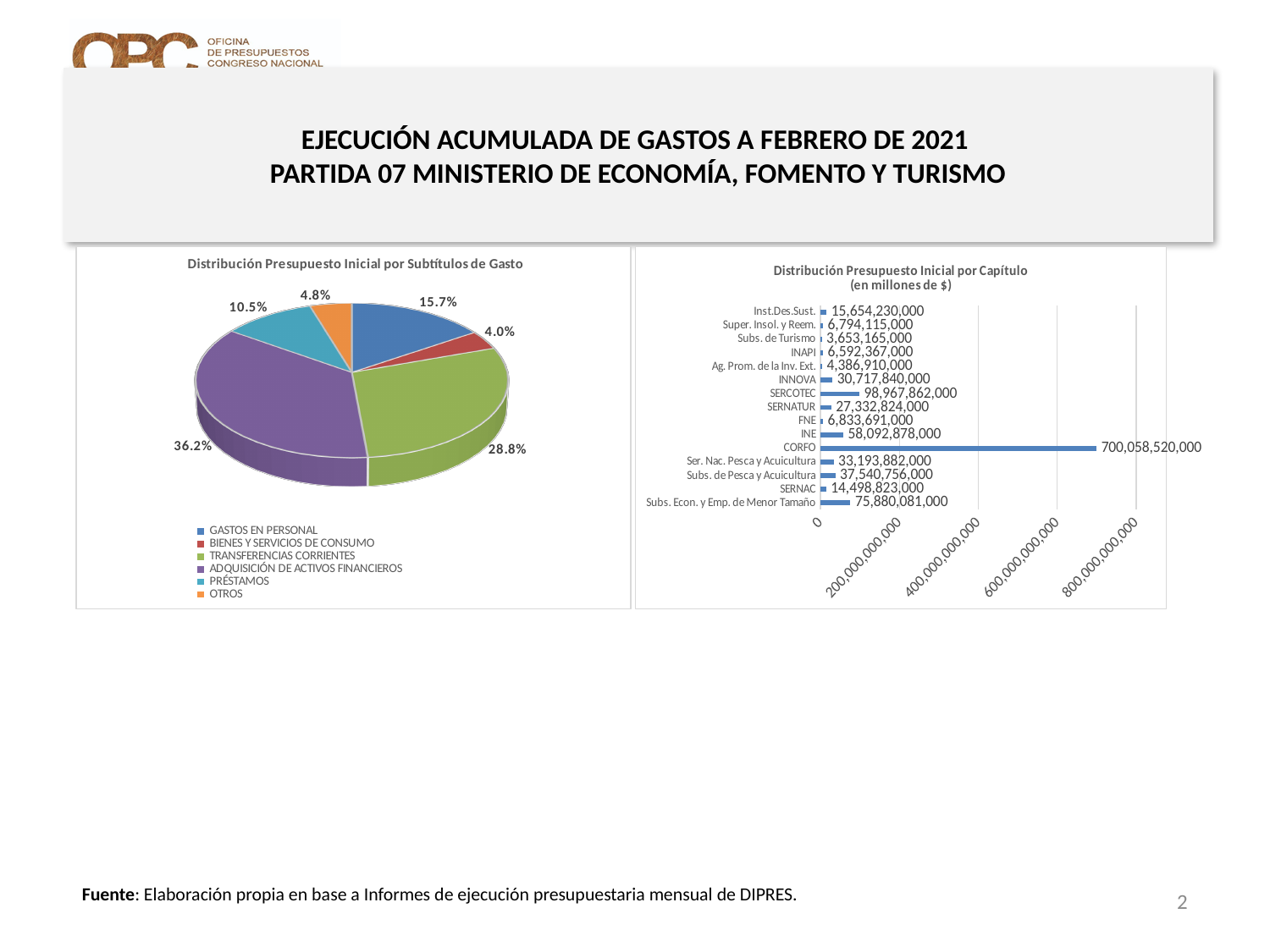
In the chart 'Distribución Presupuesto Inicial por Subtítulos de Gasto', how many categories does the legend list? 6 In the chart 'Distribución Presupuesto Inicial por Capítulo', what is the value for SERCOTEC? 98,967,862,000 In the chart 'Distribución Presupuesto Inicial por Capítulo', which is larger, INE or INNOVA? INE In the chart 'Distribución Presupuesto Inicial por Capítulo', what is the value for CORFO? 700,058,520,000 In the chart 'Distribución Presupuesto Inicial por Subtítulos de Gasto', which category has the smallest share? BIENES Y SERVICIOS DE CONSUMO In the chart 'Distribución Presupuesto Inicial por Capítulo', which category has the highest value? CORFO In the chart 'Distribución Presupuesto Inicial por Subtítulos de Gasto', what share does ADQUISICIÓN DE ACTIVOS FINANCIEROS have? 36.2% What kind of chart is 'Distribución Presupuesto Inicial por Subtítulos de Gasto'? Pie chart In the chart 'Distribución Presupuesto Inicial por Capítulo', how many categories are shown? 15 In the chart 'Distribución Presupuesto Inicial por Capítulo', which category has the lowest value? Subs. de Turismo What kind of chart is 'Distribución Presupuesto Inicial por Capítulo'? Bar chart In the chart 'Distribución Presupuesto Inicial por Subtítulos de Gasto', what share does TRANSFERENCIAS CORRIENTES have? 28.8%